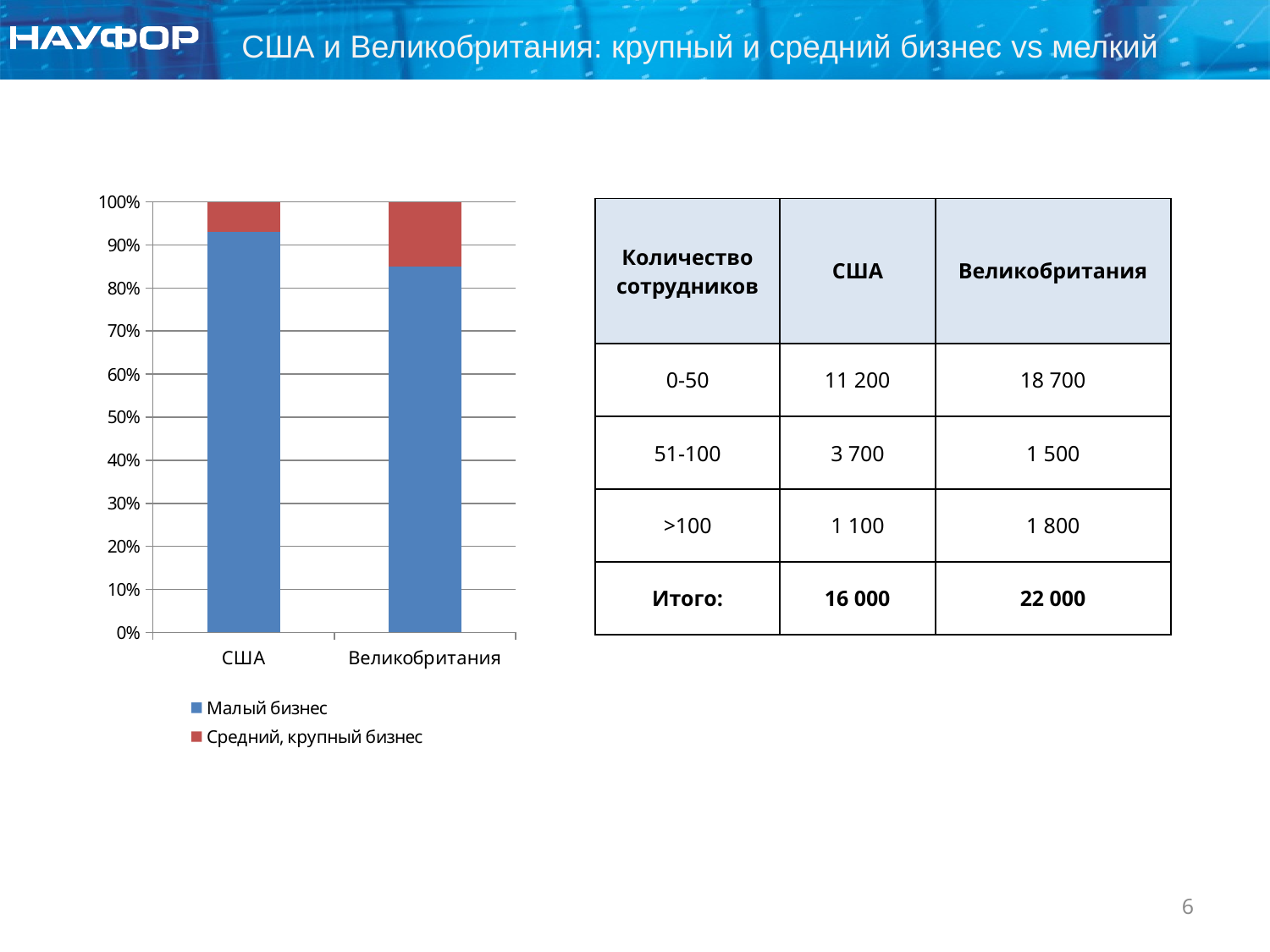
Which category has the larger share of Малый бизнес, США or Великобритания? США What is the total height of each stacked bar in the chart? 100% Which series is shown in red in the chart? Средний, крупный бизнес How many categories are shown on the x axis of the chart? 2 What kind of chart is shown on the slide? Stacked bar chart Which series is shown in blue in the chart? Малый бизнес Which category has the larger share of Средний, крупный бизнес, США or Великобритания? Великобритания Is the value for Малый бизнес in США greater or less than 90%? greater Is the value for Малый бизнес in Великобритания greater or less than 80%? greater How many series does the chart legend list? 2 Is the value for Малый бизнес in Великобритания greater or less than 90%? less What is the highest value shown on the y axis of the chart? 100%